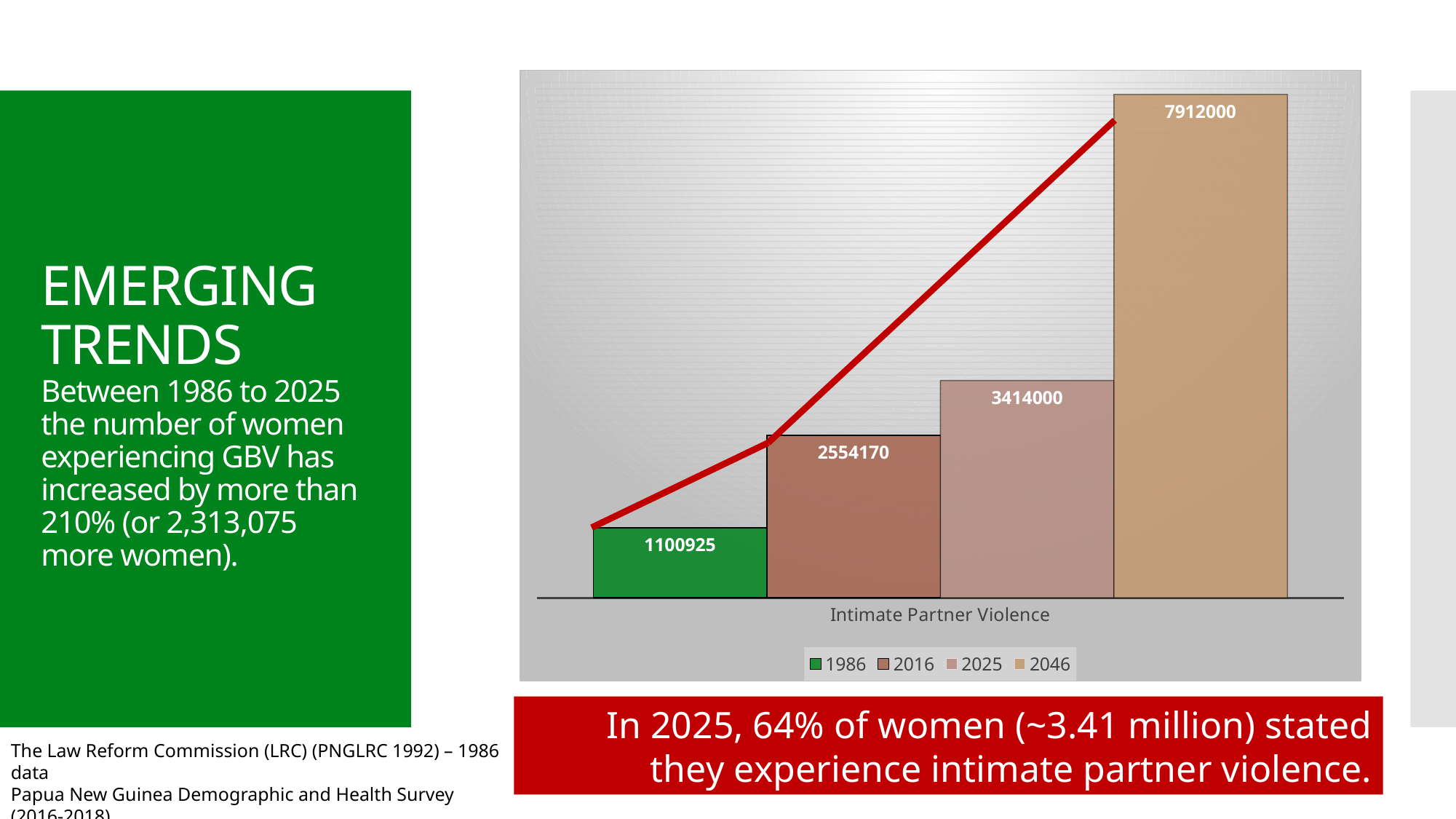
Which is larger, the value for 2016 or the value for 2025? 2025 What is the value for 2025 in the Intimate Partner Violence chart? 3414000 What is the value for 2016 in the Intimate Partner Violence chart? 2554170 How many series does the chart legend list? 4 What kind of chart is shown on the slide? Bar chart What is the value for 2046 in the Intimate Partner Violence chart? 7912000 What is the difference between the 2046 value and the 2025 value? 4498000 Which year has the highest value in the chart? 2046 What is the value for 1986 in the Intimate Partner Violence chart? 1100925 Do the values rise or fall from 1986 to 2046? Rise What is the difference between the 2016 value and the 1986 value? 1453245 Which year has the lowest value in the chart? 1986